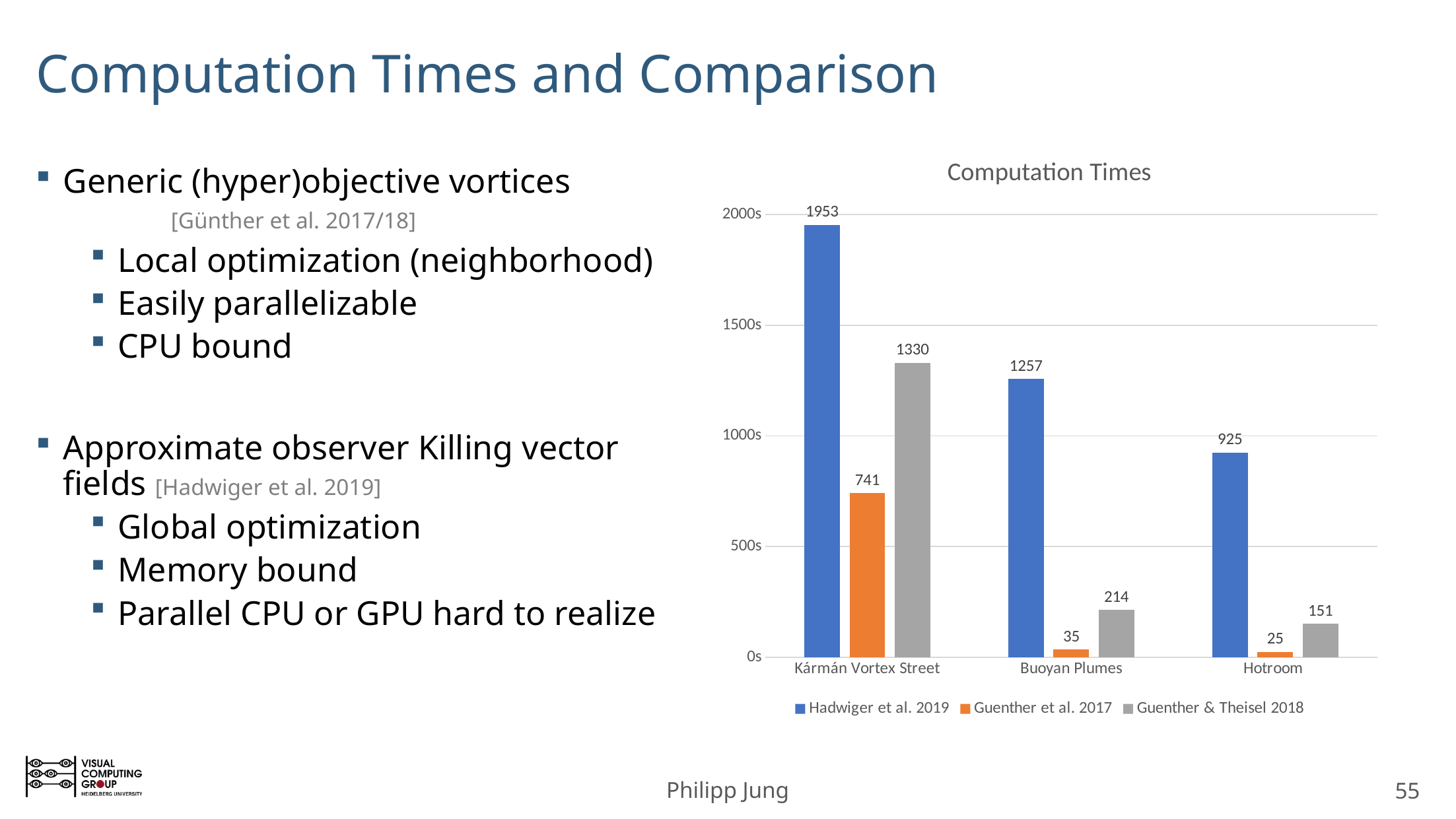
Which dataset has the lowest computation time for Guenther et al. 2017? Hotroom What is the computation time for Hadwiger et al. 2019 on the Kármán Vortex Street dataset? 1953 How many series does the chart legend list? 3 What is the computation time for Guenther & Theisel 2018 on the Hotroom dataset? 151 What is the computation time for Guenther et al. 2017 on the Buoyan Plumes dataset? 35 Which dataset has the highest computation time for Hadwiger et al. 2019? Kármán Vortex Street Is the computation time for Hadwiger et al. 2019 on the Hotroom dataset greater or less than 1000s? less How many datasets are shown on the x axis of the chart? 3 What is the title of the chart? Computation Times What is the difference between the Hadwiger et al. 2019 and Guenther & Theisel 2018 computation times on the Kármán Vortex Street dataset? 623 What kind of chart is shown on the slide? bar chart On the Buoyan Plumes dataset, which series has the larger computation time: Guenther et al. 2017 or Guenther & Theisel 2018? Guenther & Theisel 2018